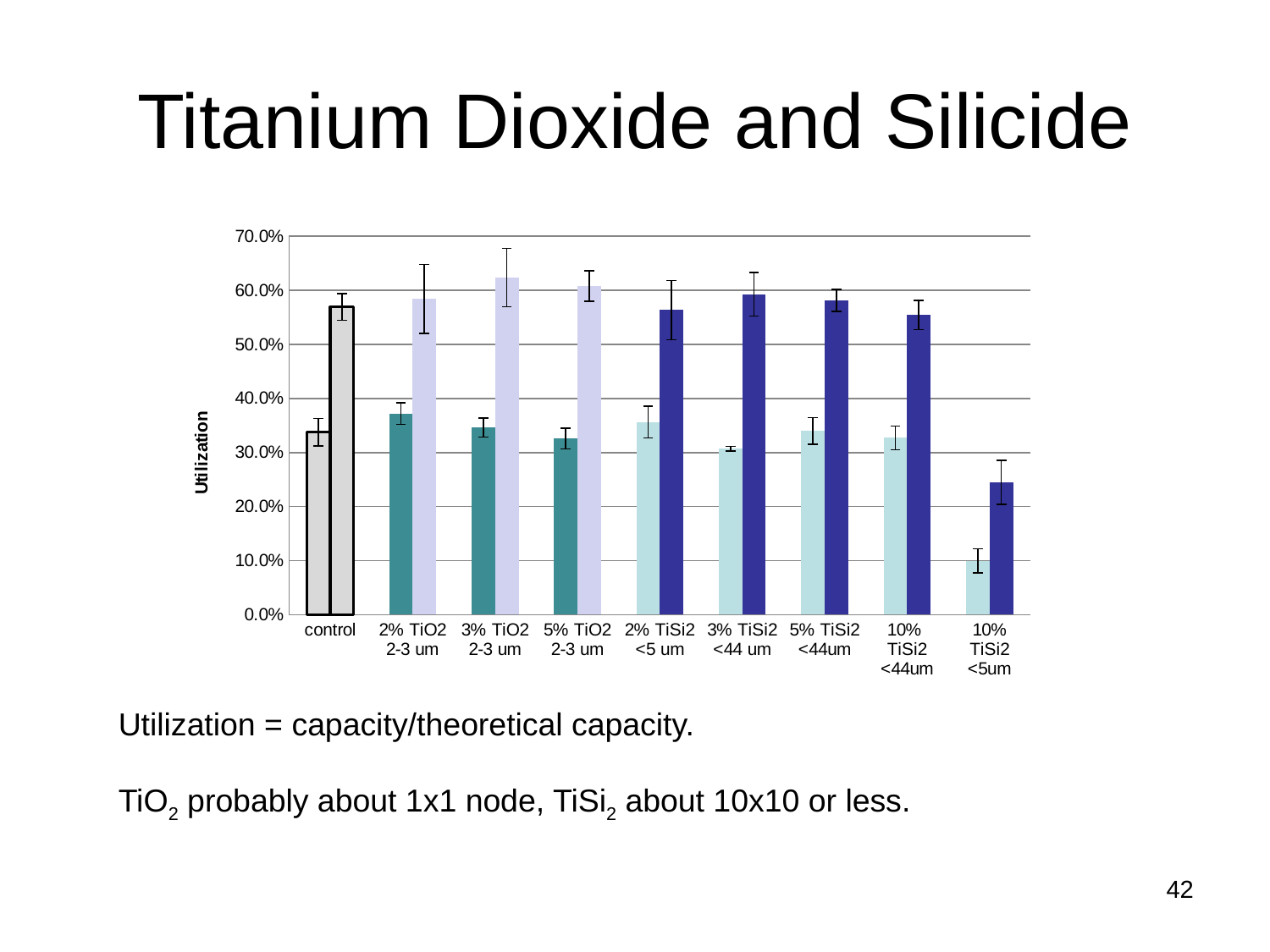
What is the label of the vertical axis of the chart? Utilization What kind of chart is shown on the slide? bar chart Is the value of the taller (right) bar for 3% TiO2 2-3 um greater or less than 60.0%? greater Is the value of the taller (right) bar for control greater or less than 50.0%? greater How many bars are plotted for each category in the chart? 2 Which has the taller right-hand bar: 5% TiSi2 <44um or 10% TiSi2 <5um? 5% TiSi2 <44um Is the value of the taller (right) bar for control greater or less than 60.0%? less How many categories are shown along the x axis of the chart? 9 Which category has the lowest bar in the chart? 10% TiSi2 <5um